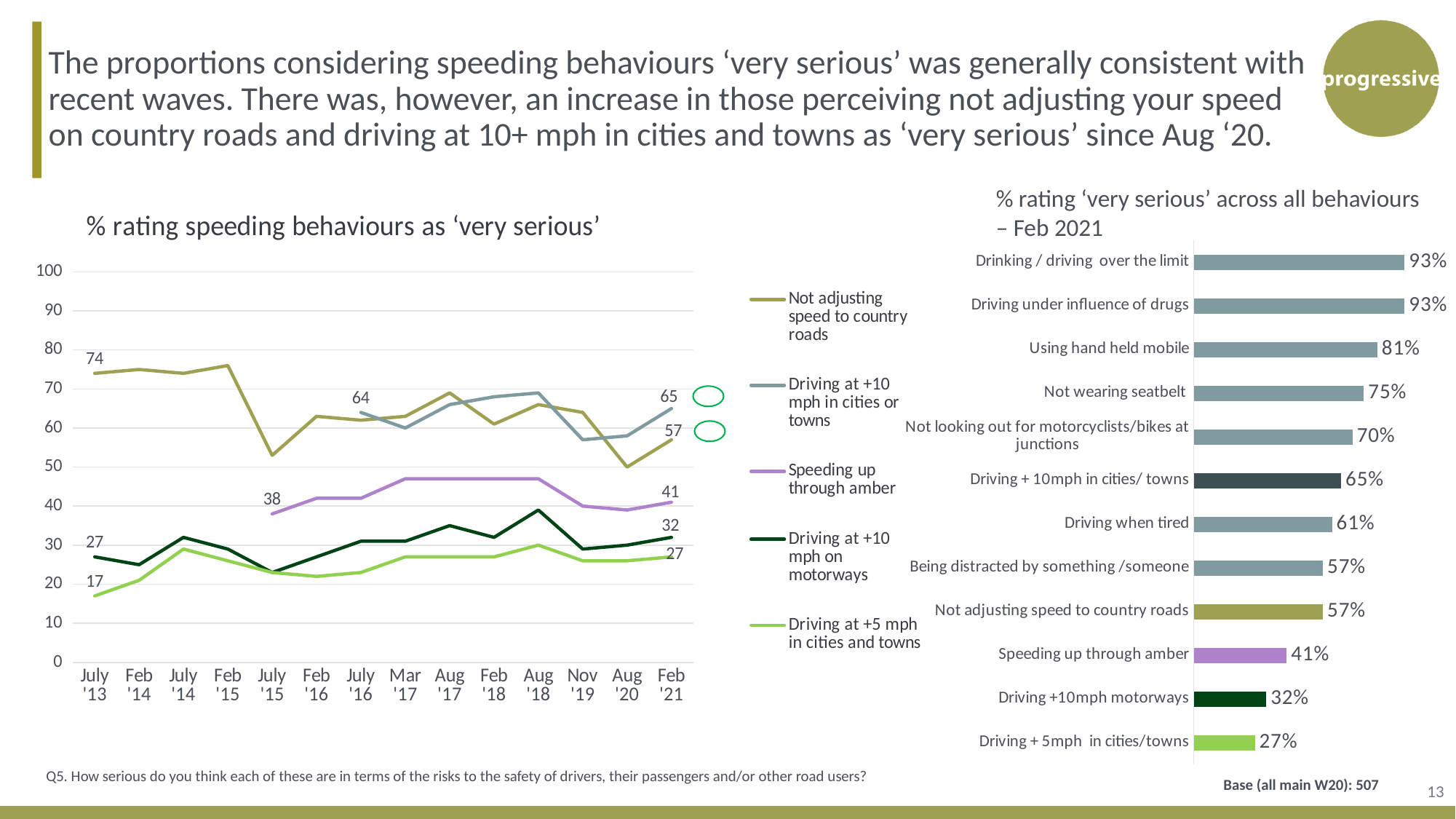
In the '% rating speeding behaviours as very serious' line chart, how many time points are shown on the x axis? 14 In the '% rating speeding behaviours as very serious' line chart, what is the value for 'Driving at +10 mph in cities or towns' in Feb '21? 65 In the '% rating speeding behaviours as very serious' line chart, what is the value for 'Not adjusting speed to country roads' in July '13? 74 In the '% rating speeding behaviours as very serious' line chart, how many series does the legend list? 5 In the '% rating speeding behaviours as very serious' line chart, what is the value for 'Speeding up through amber' in July '15? 38 In the '% rating very serious across all behaviours – Feb 2021' bar chart, what is the value for 'Not wearing seatbelt'? 75% In the '% rating very serious across all behaviours – Feb 2021' bar chart, which is larger: 'Driving when tired' or 'Speeding up through amber'? Driving when tired What kind of chart is the '% rating very serious across all behaviours – Feb 2021' chart? bar chart In the '% rating speeding behaviours as very serious' line chart, what is the difference between the Feb '21 values for 'Driving at +10 mph in cities or towns' and 'Not adjusting speed to country roads'? 8 In the '% rating speeding behaviours as very serious' line chart, is the value for 'Driving at +5 mph in cities and towns' in July '13 greater or less than 20? less In the '% rating very serious across all behaviours – Feb 2021' bar chart, how many behaviours are listed? 12 In the '% rating very serious across all behaviours – Feb 2021' bar chart, which behaviour has the lowest value? Driving + 5mph in cities/towns